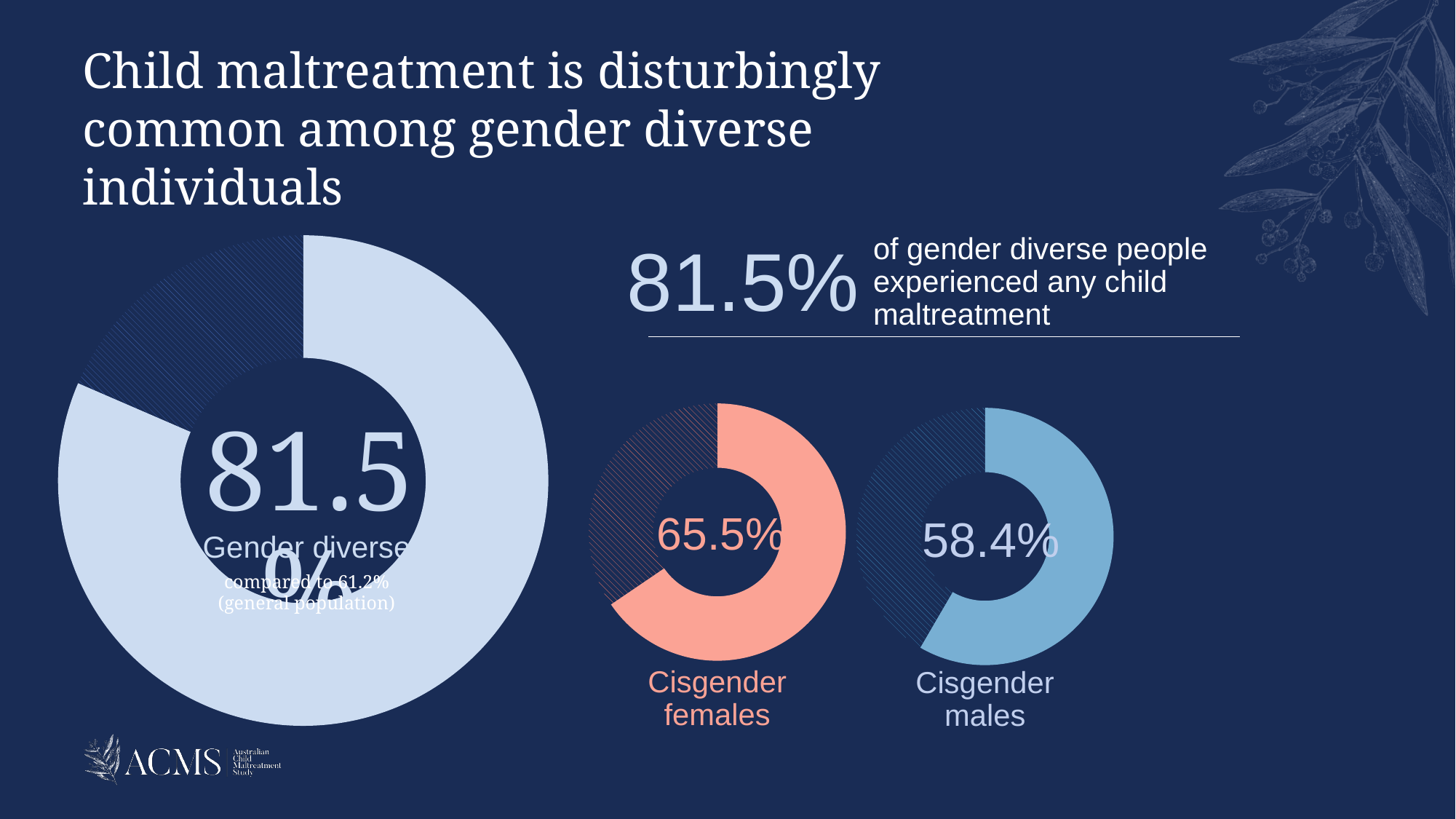
According to the Gender diverse chart, what is the general population percentage it is compared to? 61.2% What is the difference in percentage points between the Gender diverse and Cisgender males donut charts? 23.1 percentage points What kind of chart is used to show the percentages on this slide? Donut (pie) chart What percentage is shown in the Cisgender females donut chart? 65.5% Which of the three groups shown in the donut charts has the lowest percentage? Cisgender males What is the difference in percentage points between the Cisgender females and Cisgender males donut charts? 7.1 percentage points What percentage is shown in the Gender diverse donut chart? 81.5% Which of the three groups shown in the donut charts has the highest percentage? Gender diverse How many donut charts are shown on the slide? 3 What percentage is shown in the Cisgender males donut chart? 58.4% Which is larger, the value for Cisgender females or the value for Cisgender males? Cisgender females What colour is the filled portion of the Cisgender females donut chart? Salmon/orange-pink